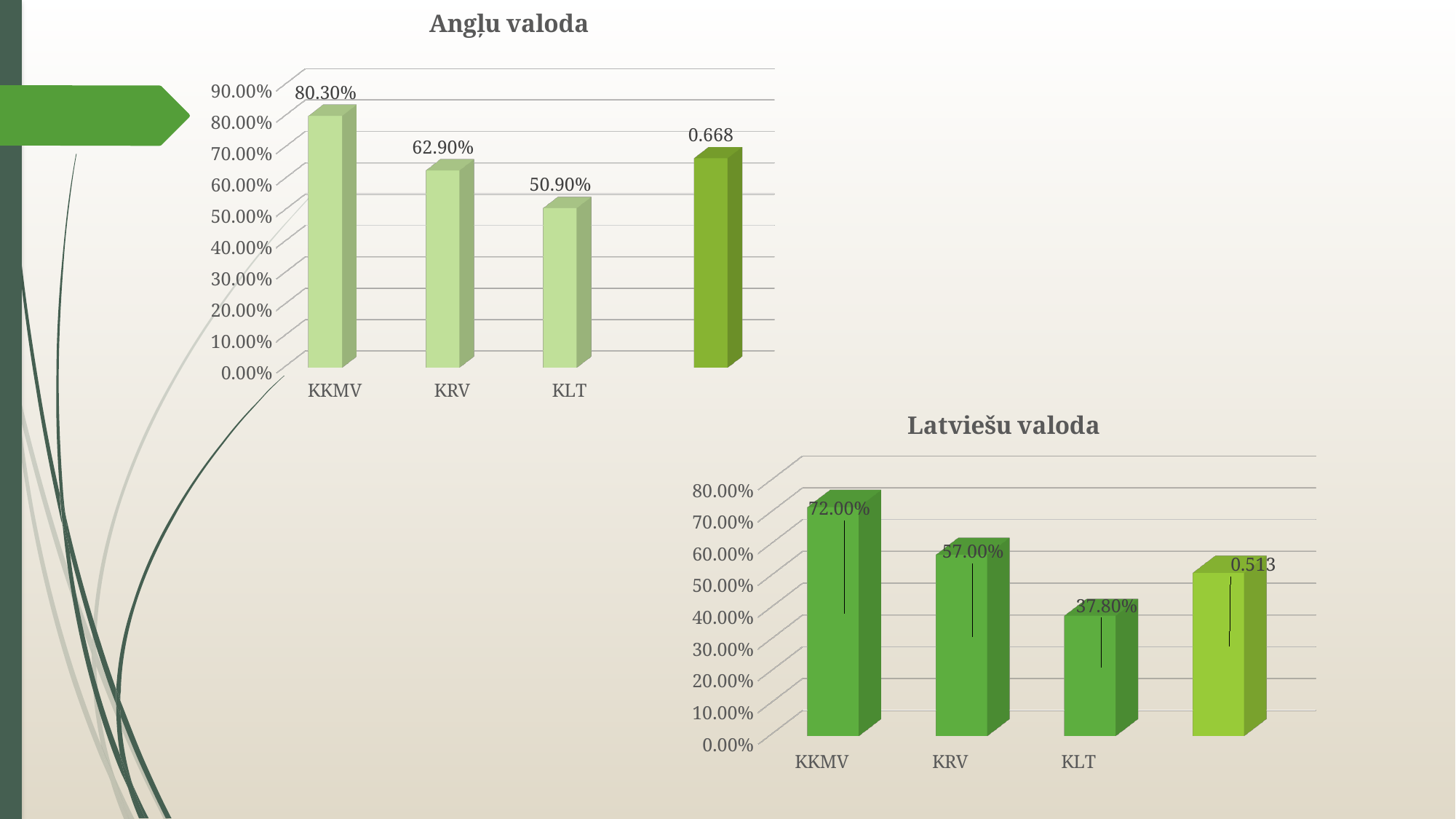
In the Angļu valoda chart, what is the value for KLT? 50.90% In the Latviešu valoda chart, which labelled category has the lowest value? KLT In the Latviešu valoda chart, do the values rise or fall from KKMV to KLT? Fall In the Latviešu valoda chart, what is the difference between the values for KKMV and KRV? 15.00% What type of chart is the Latviešu valoda chart? Bar chart In the Angļu valoda chart, what is the value for KKMV? 80.30% In the Angļu valoda chart, which labelled category has the highest value? KKMV In the Angļu valoda chart, what is the difference between the values for KKMV and KRV? 17.40% In the Latviešu valoda chart, what is the value for KKMV? 72.00% Which is larger: the value for KRV in the Angļu valoda chart or the value for KRV in the Latviešu valoda chart? Angļu valoda In the Angļu valoda chart, what is the value for KRV? 62.90% In the Latviešu valoda chart, what is the value for KLT? 37.80%